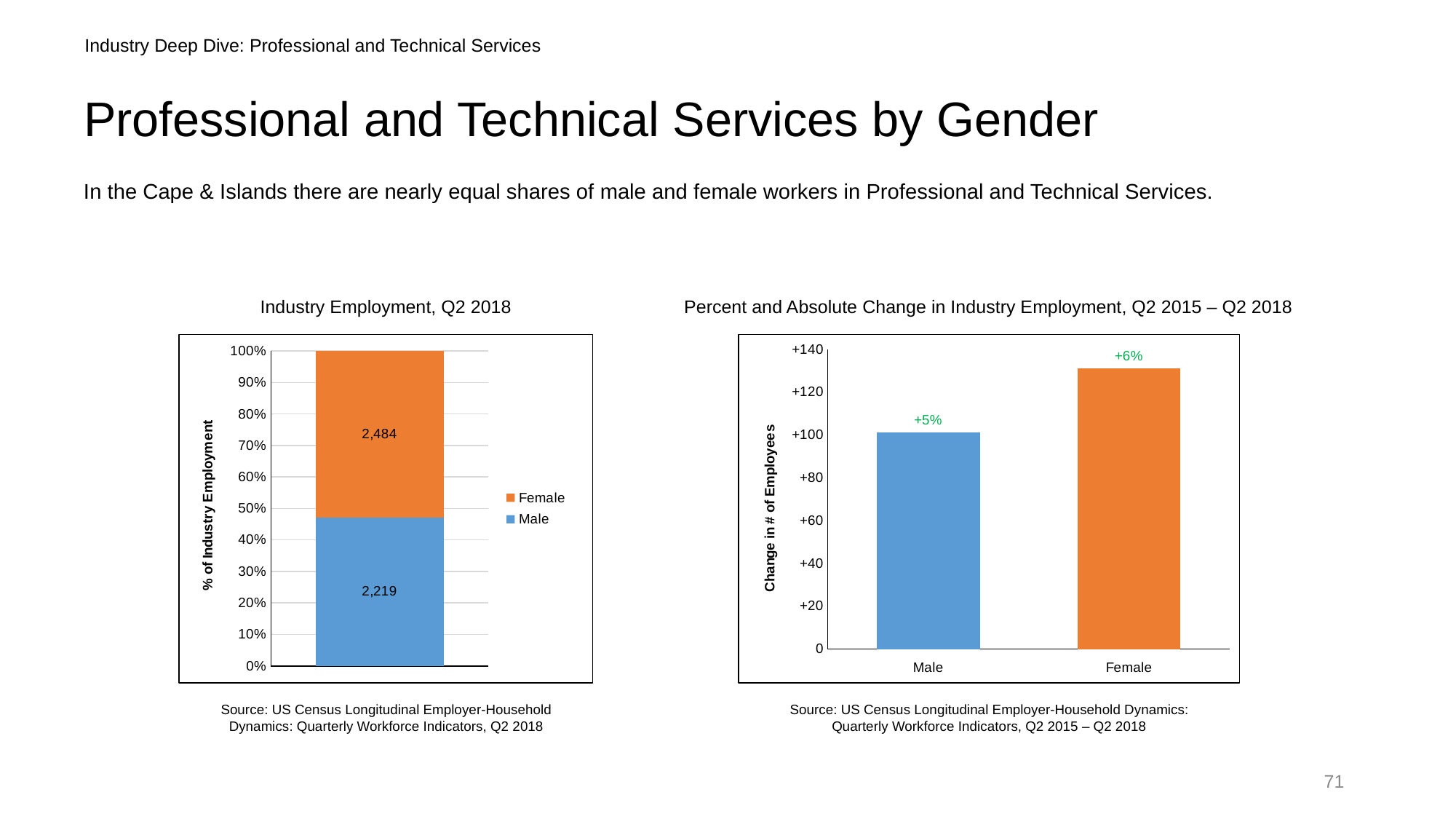
In the 'Industry Employment, Q2 2018' chart, what is the value shown for Female? 2,484 In the 'Percent and Absolute Change in Industry Employment, Q2 2015 – Q2 2018' chart, what percent change is shown for Male? +5% In the 'Percent and Absolute Change in Industry Employment, Q2 2015 – Q2 2018' chart, is the value for Female greater or less than +120? greater In the 'Industry Employment, Q2 2018' chart, what is the total of the stacked bar? 4,703 In the 'Industry Employment, Q2 2018' chart, which group has the larger value, Female or Male? Female In the 'Percent and Absolute Change in Industry Employment, Q2 2015 – Q2 2018' chart, how many categories are shown on the x axis? 2 In the 'Industry Employment, Q2 2018' chart, what kind of chart is shown? Stacked bar chart In the 'Percent and Absolute Change in Industry Employment, Q2 2015 – Q2 2018' chart, which category has the highest bar? Female In the 'Percent and Absolute Change in Industry Employment, Q2 2015 – Q2 2018' chart, what percent change is shown for Female? +6% In the 'Industry Employment, Q2 2018' chart, what is the value shown for Male? 2,219 In the 'Industry Employment, Q2 2018' chart, what is the difference between the Female and Male values? 265 In the 'Industry Employment, Q2 2018' chart, how many series does the legend list? 2